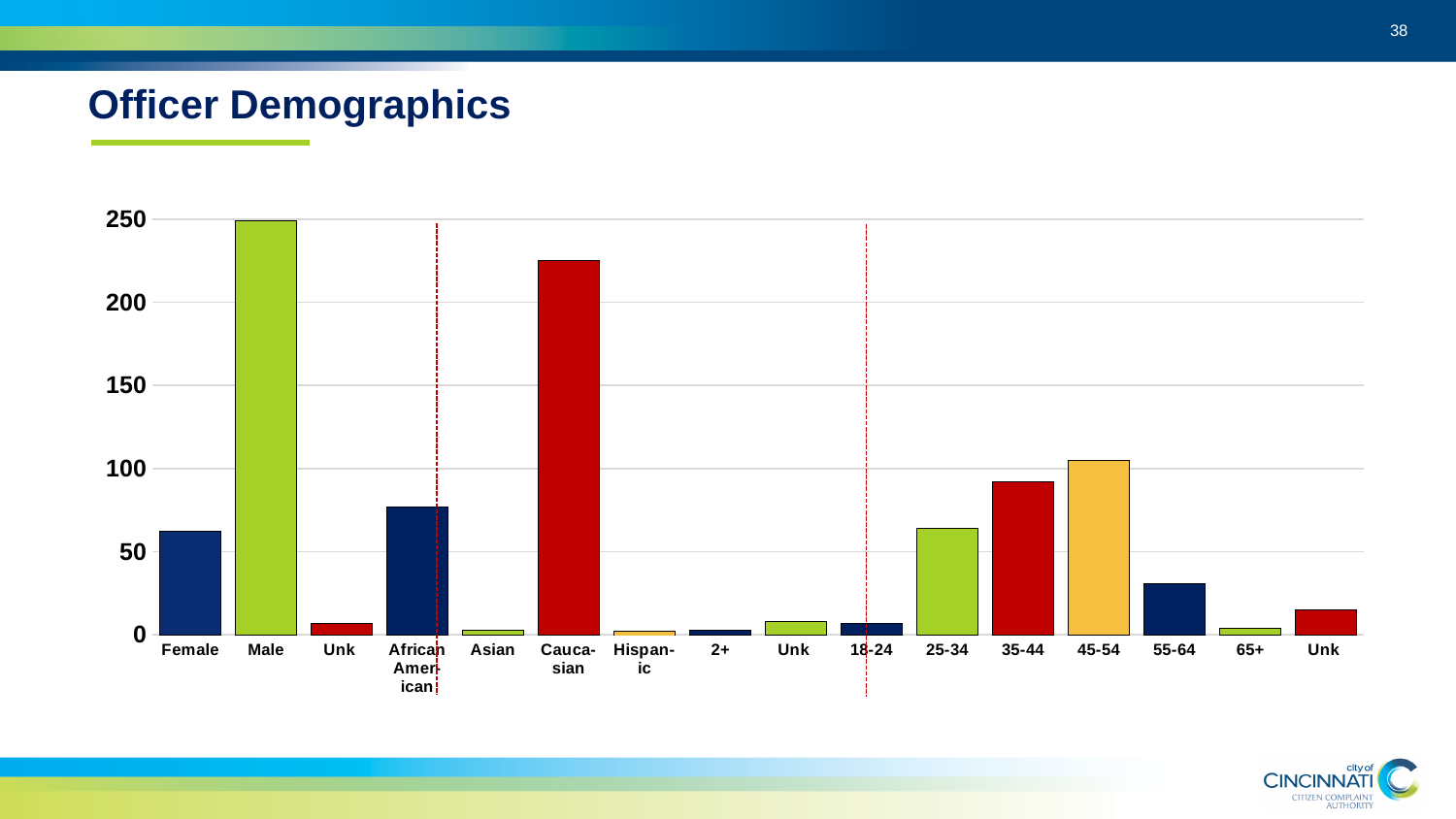
Is the value for 35-44 greater or less than 100? less What is the title of the chart? Officer Demographics What kind of chart is shown on the slide? bar chart Is the value for 55-64 greater or less than 50? less Which is larger, the value for African American or the value for Female? African American Which is larger, the value for 25-34 or the value for 55-64? 25-34 Is the value for African American greater or less than 100? less Which is larger, the value for Male or the value for Caucasian? Male Which category has the highest bar in the chart? Male How many categories are shown on the x axis of the chart? 16